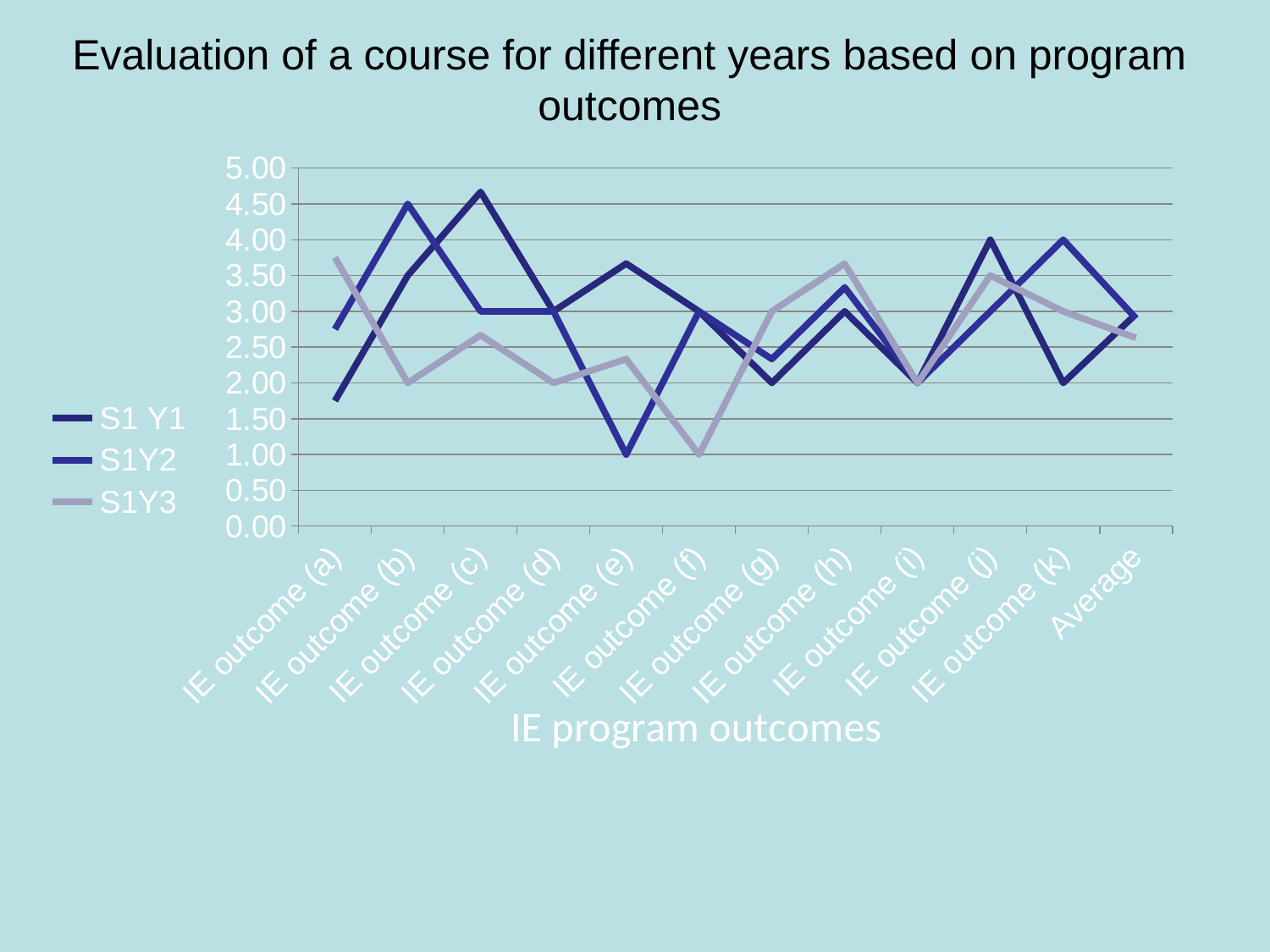
Is the value of S1 Y1 at IE outcome (c) greater or less than 4.00? greater What is the title of the x axis? IE program outcomes At IE outcome (e), which series has the larger value, S1 Y1 or S1Y2? S1 Y1 How many series does the legend list? 3 At IE outcome (c), which series has the larger value, S1 Y1 or S1Y3? S1 Y1 For which category does the S1Y3 series reach its lowest value? IE outcome (f) Is the value of S1Y2 at IE outcome (b) greater or less than 4.00? greater What are the three series named in the legend? S1 Y1, S1Y2, S1Y3 Is the value of S1Y3 at IE outcome (f) greater or less than 2.00? less How many categories are plotted along the x axis? 12 What kind of chart is shown on the slide? line chart